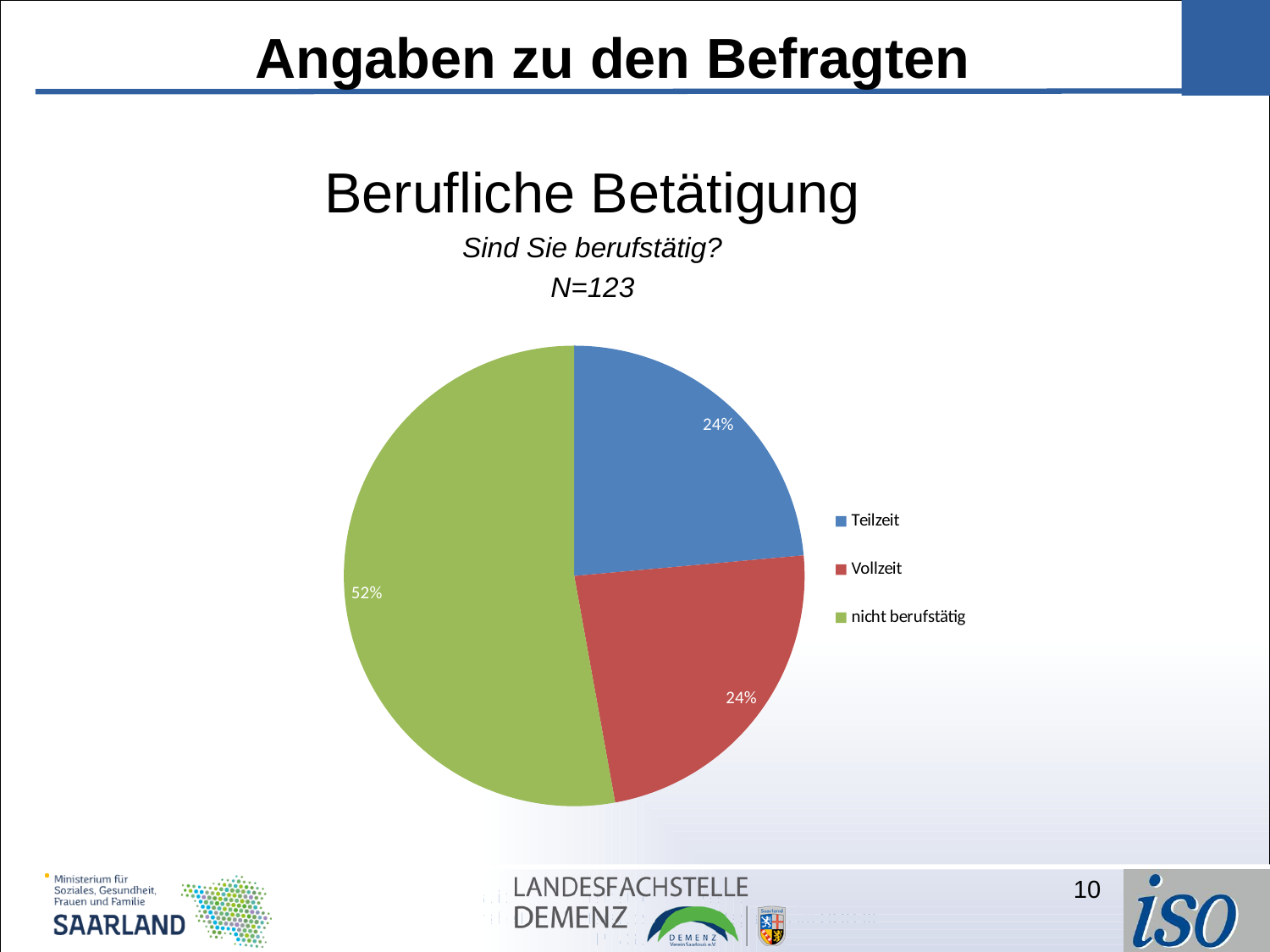
What is the title of the chart? Berufliche Betätigung What share of respondents are 'nicht berufstätig'? 52% How many entries does the legend list? 3 What percentage of respondents work 'Teilzeit'? 24% What kind of chart is shown on the slide? pie chart Is the share for 'nicht berufstätig' greater or less than 50%? greater What is the sample size (N) given for the chart? N=123 Which is larger, the share for 'nicht berufstätig' or the share for 'Vollzeit'? nicht berufstätig What is the difference in percentage points between 'nicht berufstätig' and 'Teilzeit'? 28 percentage points What percentage of respondents work 'Vollzeit'? 24% How many slices does the pie chart have? 3 Which category has the largest slice of the pie? nicht berufstätig